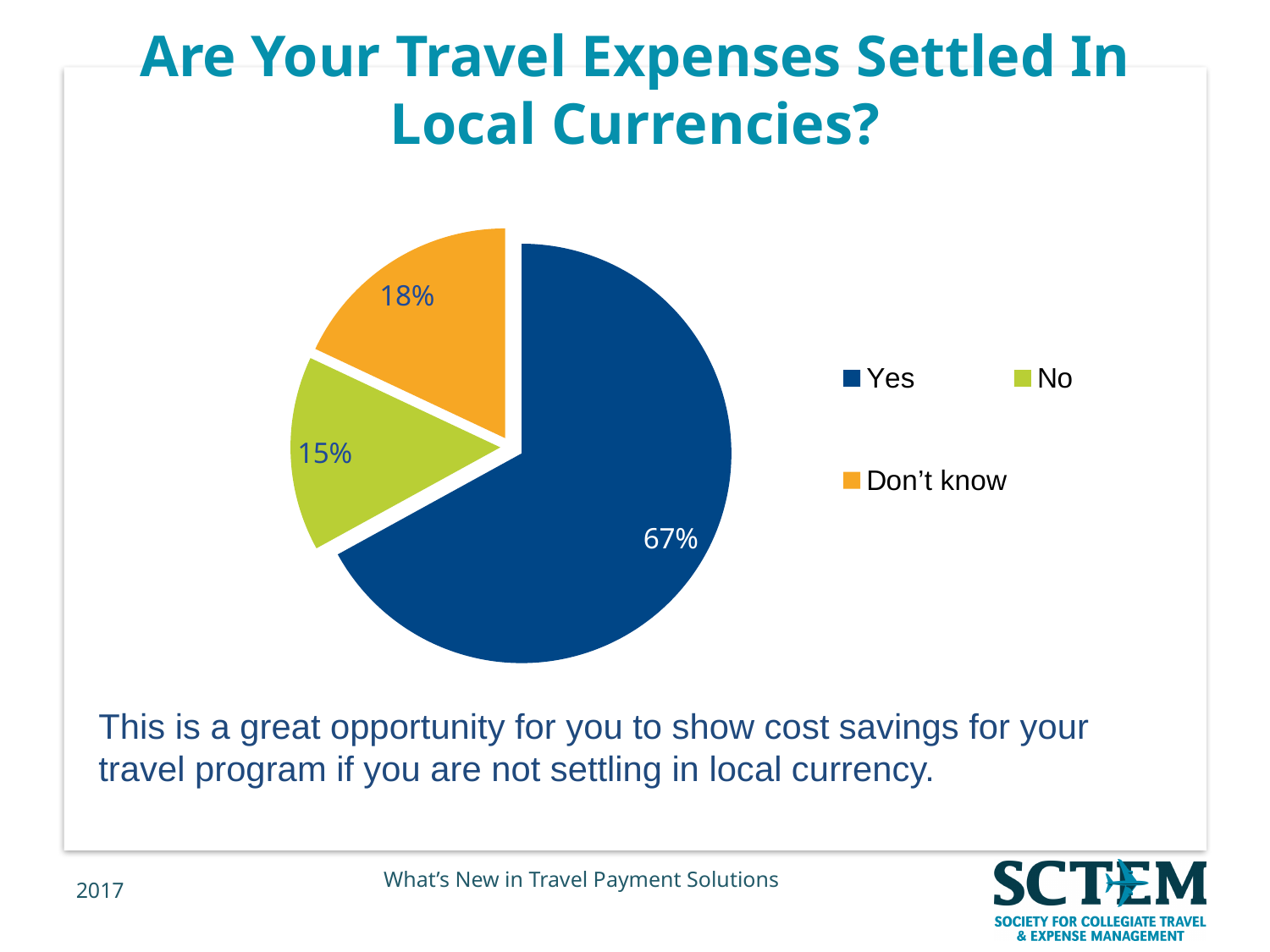
Which response has the smallest share of the pie? No What colour is the "Don't know" slice? Orange What percentage of respondents answered "No"? 15% Which is larger, the "Don't know" slice or the "No" slice? Don't know Which response has the largest share of the pie? Yes What percentage of respondents answered "Yes"? 67% What kind of chart is shown on the slide? Pie chart What percentage of respondents answered "Don't know"? 18% How many entries does the legend list? 3 How many slices does the pie chart have? 3 What is the difference in percentage points between the "Don't know" and "No" slices? 3 What is the difference in percentage points between the "Yes" and "No" slices? 52